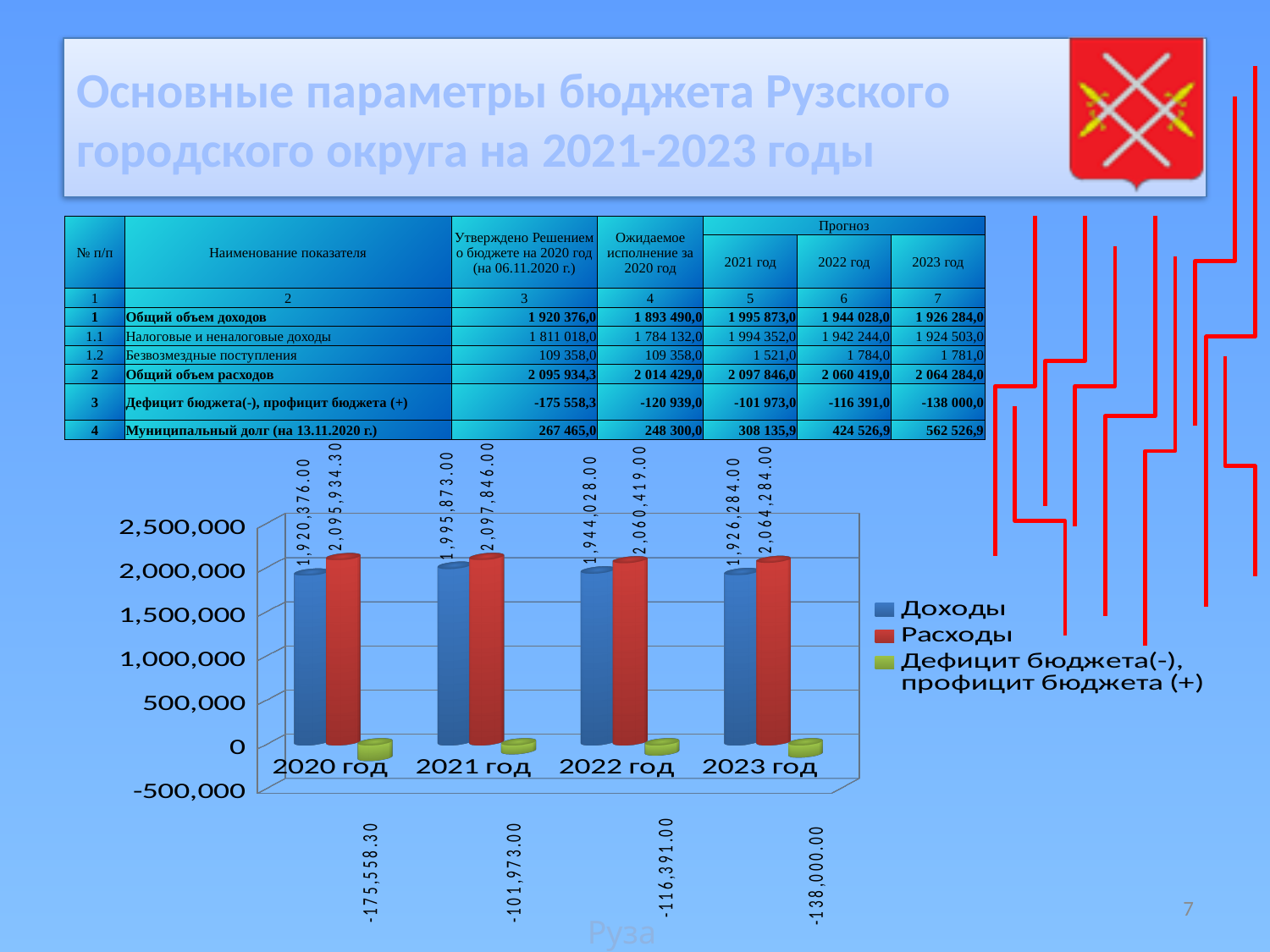
What is the value for Дефицит бюджета(-), профицит бюджета (+) in 2023 год? -138,000.00 How many series does the chart legend list? 3 Which is larger in 2022 год, Доходы or Расходы? Расходы What is the value for Доходы in 2021 год? 1,995,873.00 In which year is Доходы highest? 2021 год What is the difference between Расходы and Доходы in 2021 год? 101,973.00 In which year is Доходы lowest? 2020 год What kind of chart is shown on the slide? bar chart How many years are shown on the x axis of the chart? 4 Is the value for Расходы in 2023 год greater or less than 2,000,000? greater In which year is the budget deficit (Дефицит бюджета) the most negative? 2020 год What is the value for Расходы in 2020 год? 2,095,934.30